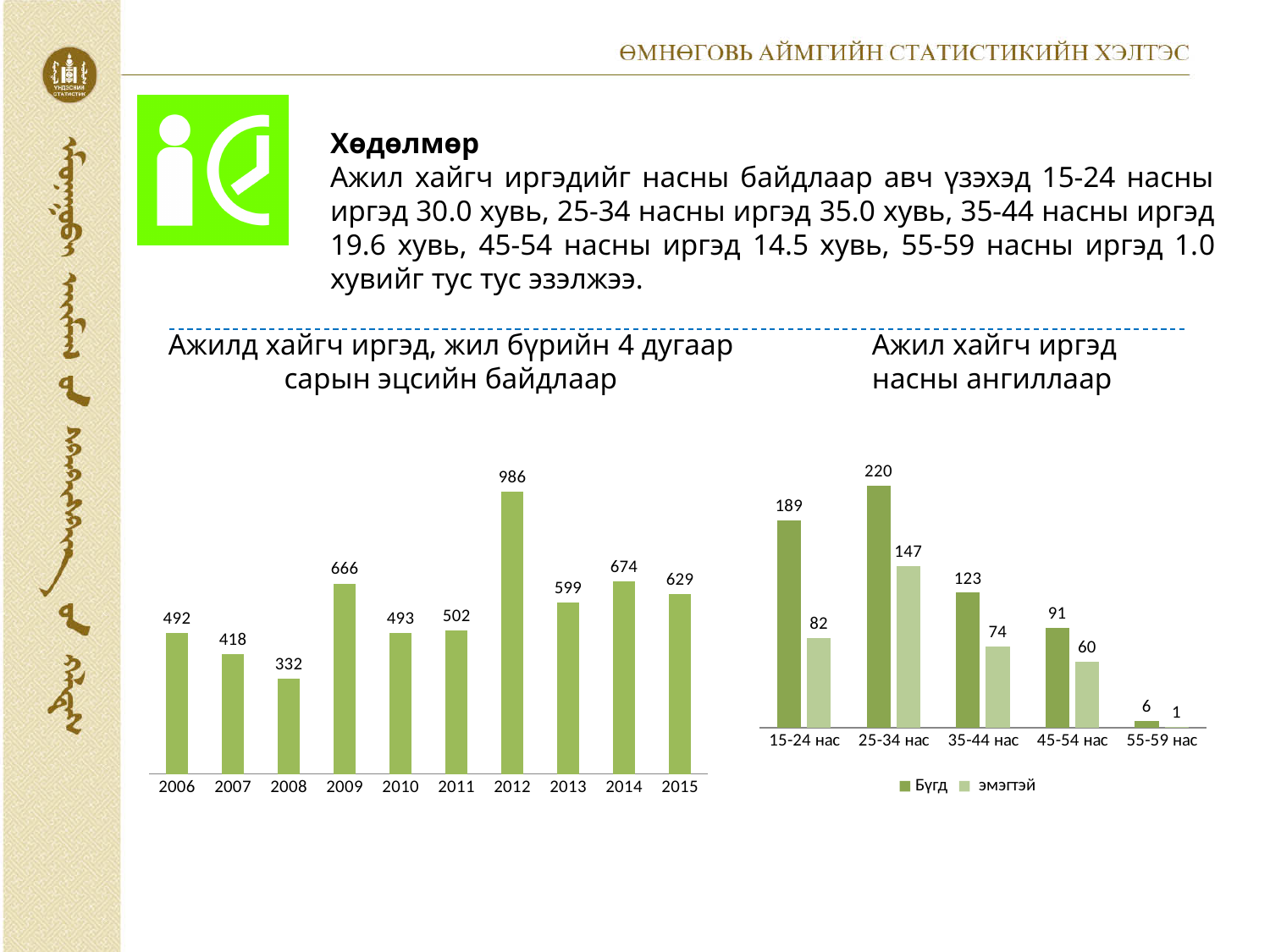
In the right chart (Ажил хайгч иргэд насны ангиллаар), which age group has the lowest Бүгд value? 55-59 нас In the left chart (Ажилд хайгч иргэд, жил бүрийн 4 дугаар сарын эцсийн байдлаар), which year has the highest value? 2012 In the left chart (Ажилд хайгч иргэд, жил бүрийн 4 дугаар сарын эцсийн байдлаар), which year has the lowest value? 2008 In the left chart (Ажилд хайгч иргэд, жил бүрийн 4 дугаар сарын эцсийн байдлаар), what is the difference between the values for 2014 and 2015? 45 In the right chart (Ажил хайгч иргэд насны ангиллаар), what is the difference between the Бүгд and эмэгтэй values for 15-24 нас? 107 In the left chart (Ажилд хайгч иргэд, жил бүрийн 4 дугаар сарын эцсийн байдлаар), what is the value for 2012? 986 In the right chart (Ажил хайгч иргэд насны ангиллаар), how many series does the legend list? 2 What kind of chart is the left chart (Ажилд хайгч иргэд, жил бүрийн 4 дугаар сарын эцсийн байдлаар)? bar chart In the right chart (Ажил хайгч иргэд насны ангиллаар), what is the Бүгд value for 25-34 нас? 220 In the right chart (Ажил хайгч иргэд насны ангиллаар), what is the эмэгтэй value for 45-54 нас? 60 In the left chart (Ажилд хайгч иргэд, жил бүрийн 4 дугаар сарын эцсийн байдлаар), how many years are shown? 10 In the left chart (Ажилд хайгч иргэд, жил бүрийн 4 дугаар сарын эцсийн байдлаар), is the value for 2009 larger or smaller than the value for 2013? larger